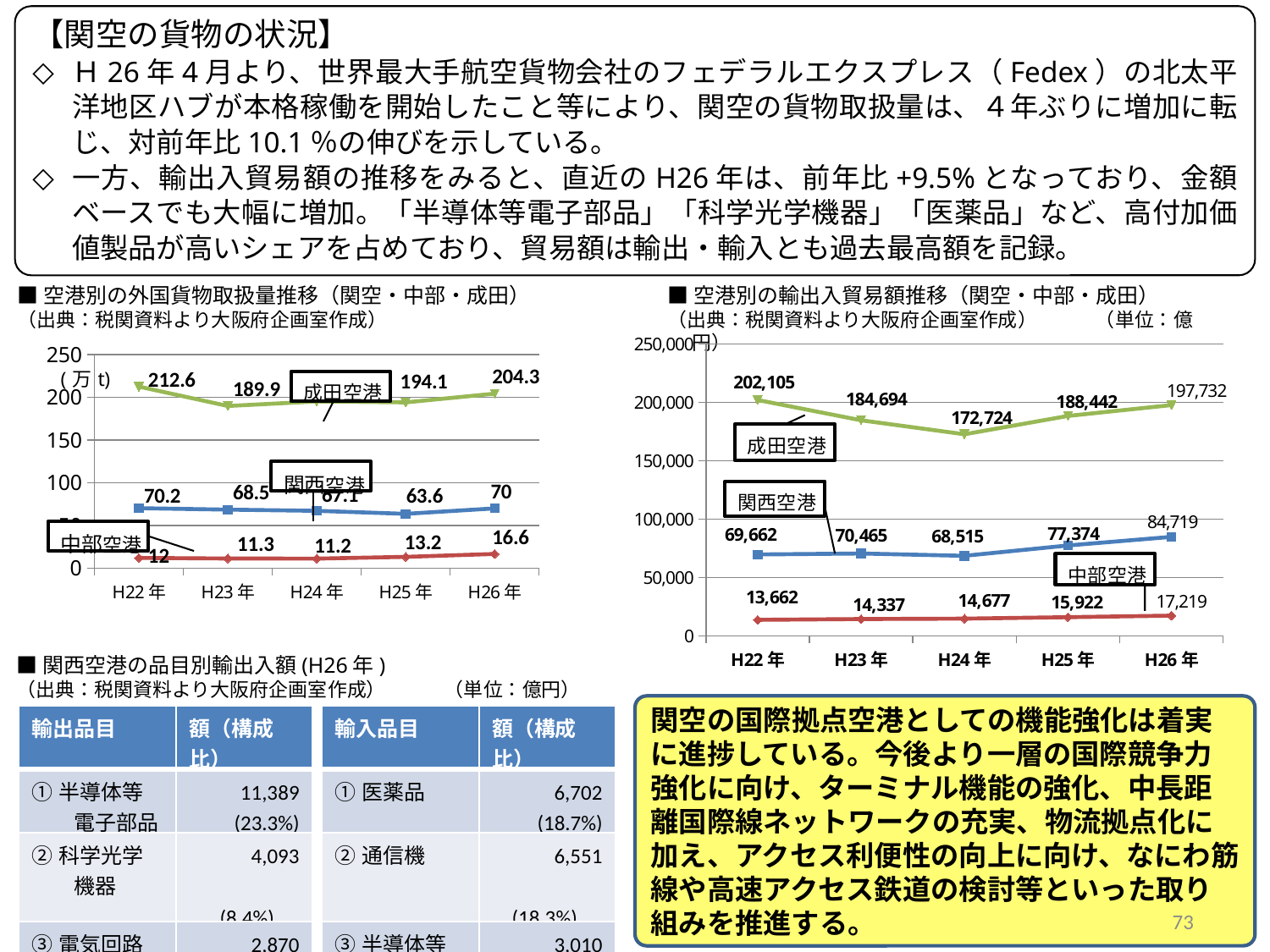
In the right chart (空港別の輸出入貿易額推移), what is the value for 関西空港 in H26年? 84,719 In the left chart (空港別の外国貨物取扱量推移), which airport has the lowest value in H26年? 中部空港 In the right chart (空港別の輸出入貿易額推移), what is the difference between 関西空港 in H26年 and H25年? 7,345 In the right chart (空港別の輸出入貿易額推移), which airport has the highest value in H22年? 成田空港 What kind of chart is the right chart (空港別の輸出入貿易額推移)? line chart In the left chart (空港別の外国貨物取扱量推移), what is the difference between 成田空港 and 関西空港 in H26年? 134.3 In the left chart (空港別の外国貨物取扱量推移), how many years are shown on the x axis? 5 In the right chart (空港別の輸出入貿易額推移), does the value for 中部空港 rise or fall from H22年 to H26年? rise In the left chart (空港別の外国貨物取扱量推移), what is the value for 中部空港 in H25年? 13.2 In the left chart (空港別の外国貨物取扱量推移), what is the value for 成田空港 in H22年? 212.6 In the right chart (空港別の輸出入貿易額推移), what is the value for 成田空港 in H24年? 172,724 In the left chart (空港別の外国貨物取扱量推移), what is the value for 関西空港 in H26年? 70